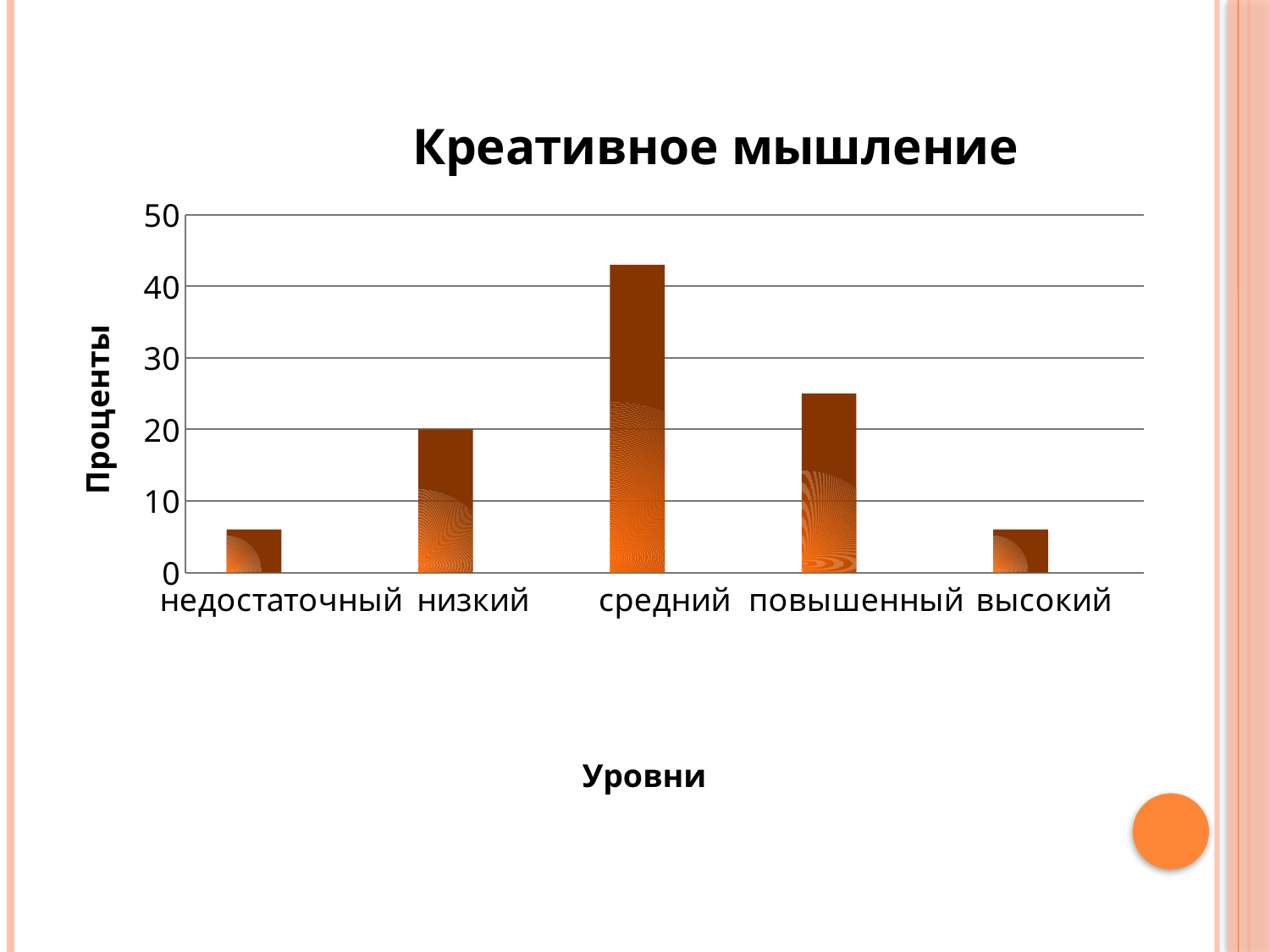
What is the label of the vertical axis? Проценты What is the value for низкий? 20 Which is larger, the value for низкий or the value for высокий? низкий Is the value for высокий greater or less than 10? less What kind of chart is shown on the slide? bar chart What is the title of the chart? Креативное мышление Which category has the highest value? средний Is the value for средний greater or less than 40? greater How many categories are shown on the x axis? 5 Is the value for повышенный greater or less than 30? less Which is larger, the value for средний or the value for повышенный? средний